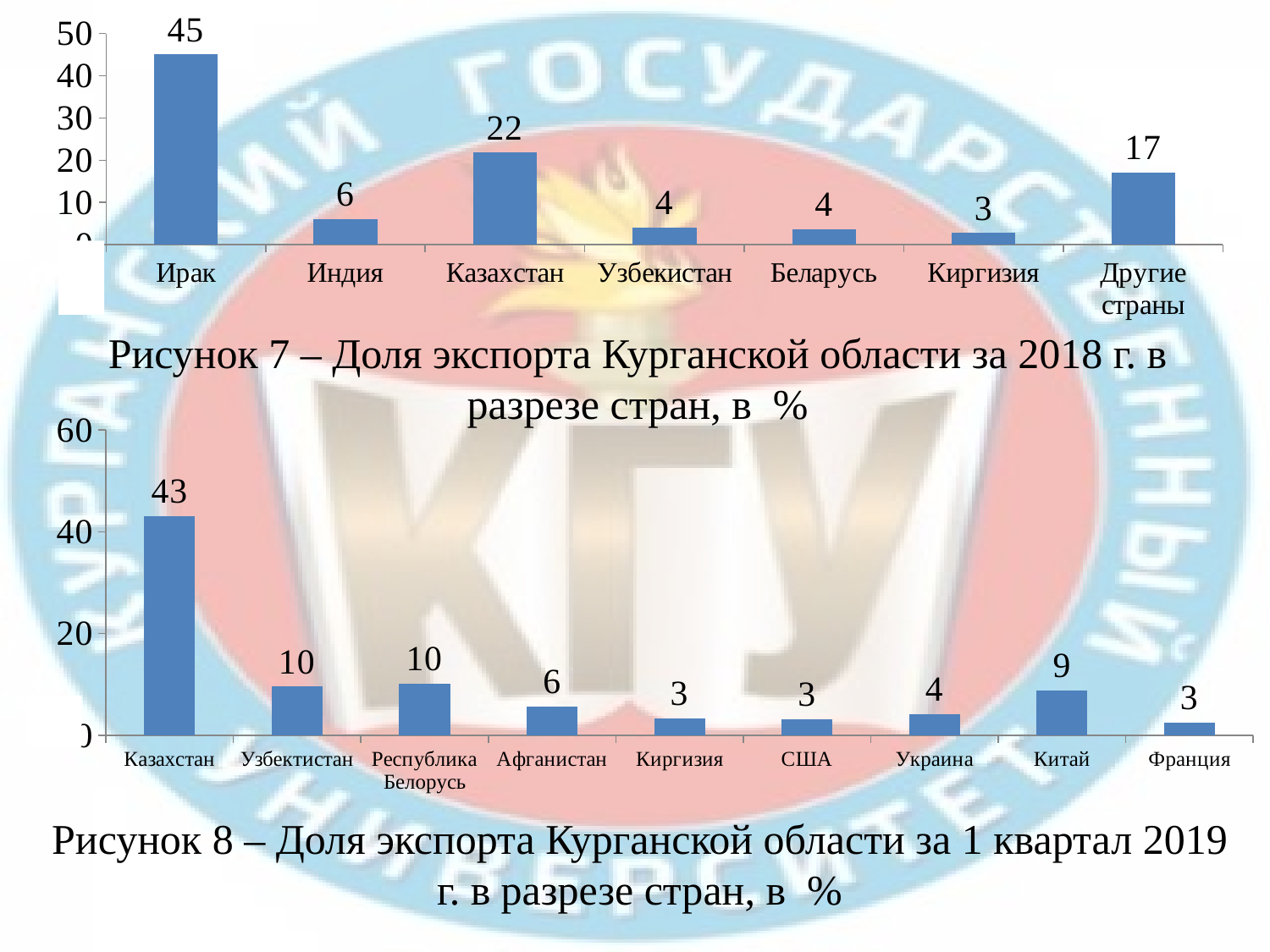
What kind of chart is the bottom chart (Рисунок 8)? Bar chart In the top chart (Рисунок 7, 2018), what is the difference between the values for Ирак and Другие страны? 28 In the top chart (Рисунок 7, 2018), how many categories are shown on the x axis? 7 In the top chart (Рисунок 7, 2018), which category has the lowest value? Киргизия In the bottom chart (Рисунок 8, 1 квартал 2019), which category has the highest value? Казахстан In the bottom chart (Рисунок 8, 1 квартал 2019), what is the difference between the values for Казахстан and Узбекистан? 33 In the bottom chart (Рисунок 8, 1 квартал 2019), what is the value for Китай? 9 In the bottom chart (Рисунок 8, 1 квартал 2019), how many categories are shown on the x axis? 9 In the top chart (Рисунок 7, 2018), what is the value for Казахстан? 22 In the top chart (Рисунок 7, 2018), what is the value for Ирак? 45 In the top chart (Рисунок 7, 2018), which is larger, the value for Индия or the value for Узбекистан? Индия In the bottom chart (Рисунок 8, 1 квартал 2019), what is the value for Казахстан? 43